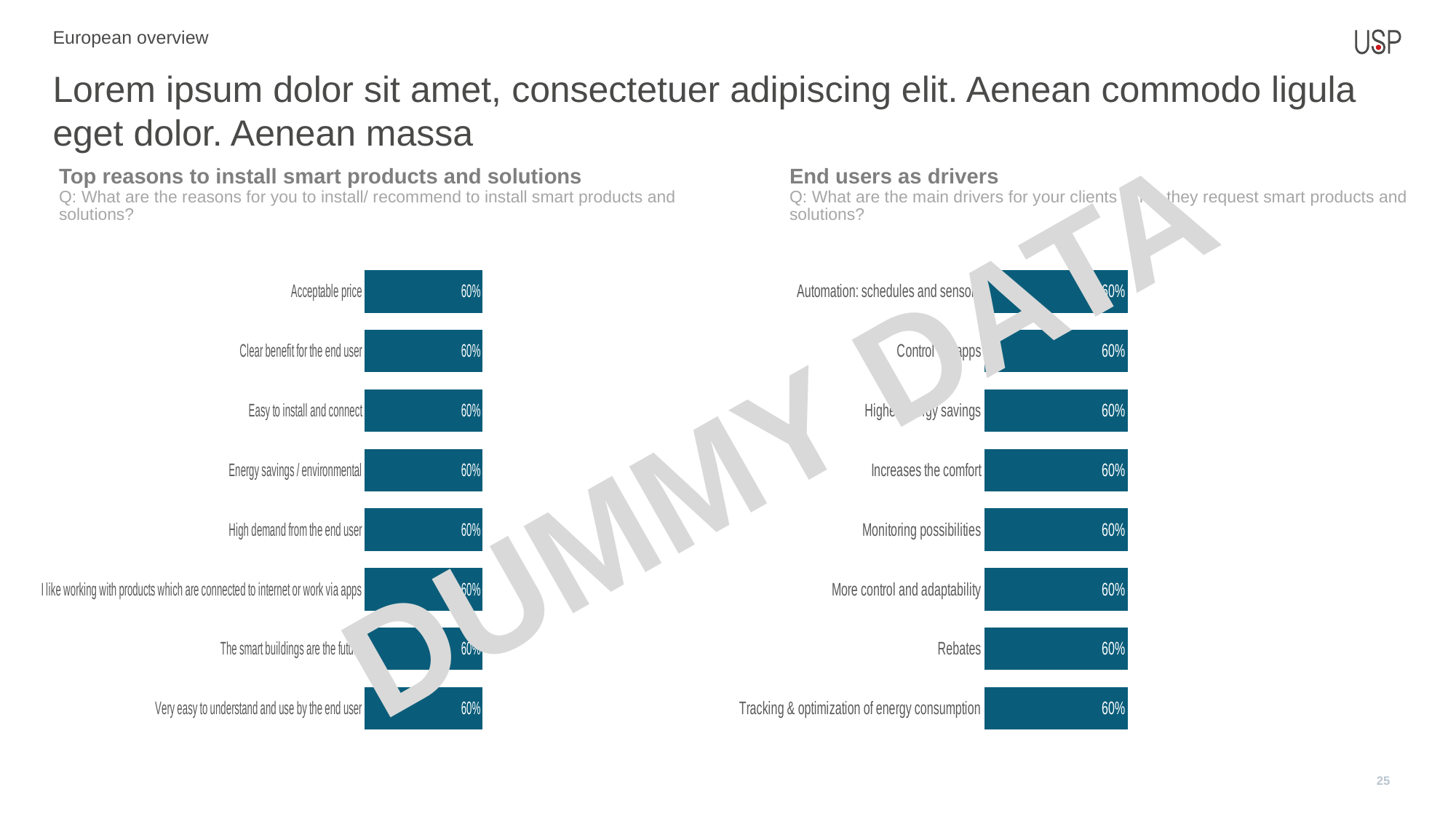
In the 'End users as drivers' chart, what is the value for Tracking & optimization of energy consumption? 60% What kind of chart is the 'Top reasons to install smart products and solutions' chart? Bar chart In the 'Top reasons to install smart products and solutions' chart, what is the value for Acceptable price? 60% What is the title of the chart on the right side of the slide? End users as drivers In the 'Top reasons to install smart products and solutions' chart, what is the difference between the values for Acceptable price and High demand from the end user? 0% How many categories are shown in the 'Top reasons to install smart products and solutions' chart? 8 In the 'Top reasons to install smart products and solutions' chart, what is the value for Energy savings / environmental? 60% In the 'Top reasons to install smart products and solutions' chart, what is the value for Very easy to understand and use by the end user? 60% How many categories are shown in the 'End users as drivers' chart? 8 In the 'End users as drivers' chart, what is the difference between the values for Monitoring possibilities and More control and adaptability? 0% In the 'End users as drivers' chart, what is the value for Increases the comfort? 60% In the 'End users as drivers' chart, what is the value for Rebates? 60%